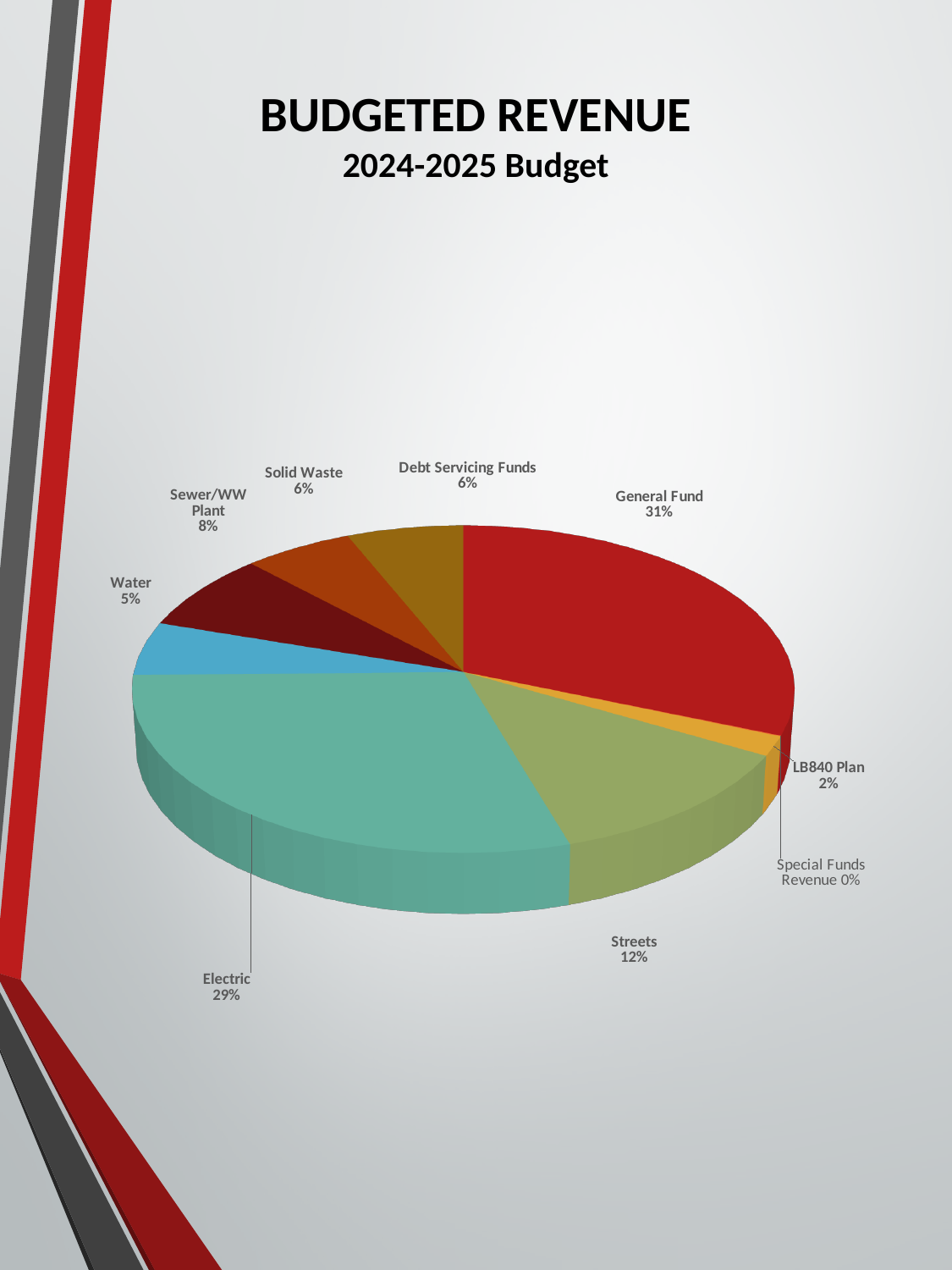
Which category has the largest share of budgeted revenue? General Fund Which category has the smallest share of budgeted revenue? Special Funds Revenue What percentage is shown for Sewer/WW Plant? 8% Which is larger, the share for Streets or the share for Sewer/WW Plant? Streets What percentage is shown for Water? 5% How many categories are shown in the pie chart? 9 What share of budgeted revenue does Electric represent? 29% What kind of chart is shown on the slide? Pie chart What is the difference in percentage points between General Fund and Electric? 2 What percentage is shown for Streets? 12% What percentage is shown for LB840 Plan? 2% What share of budgeted revenue does the General Fund represent? 31%